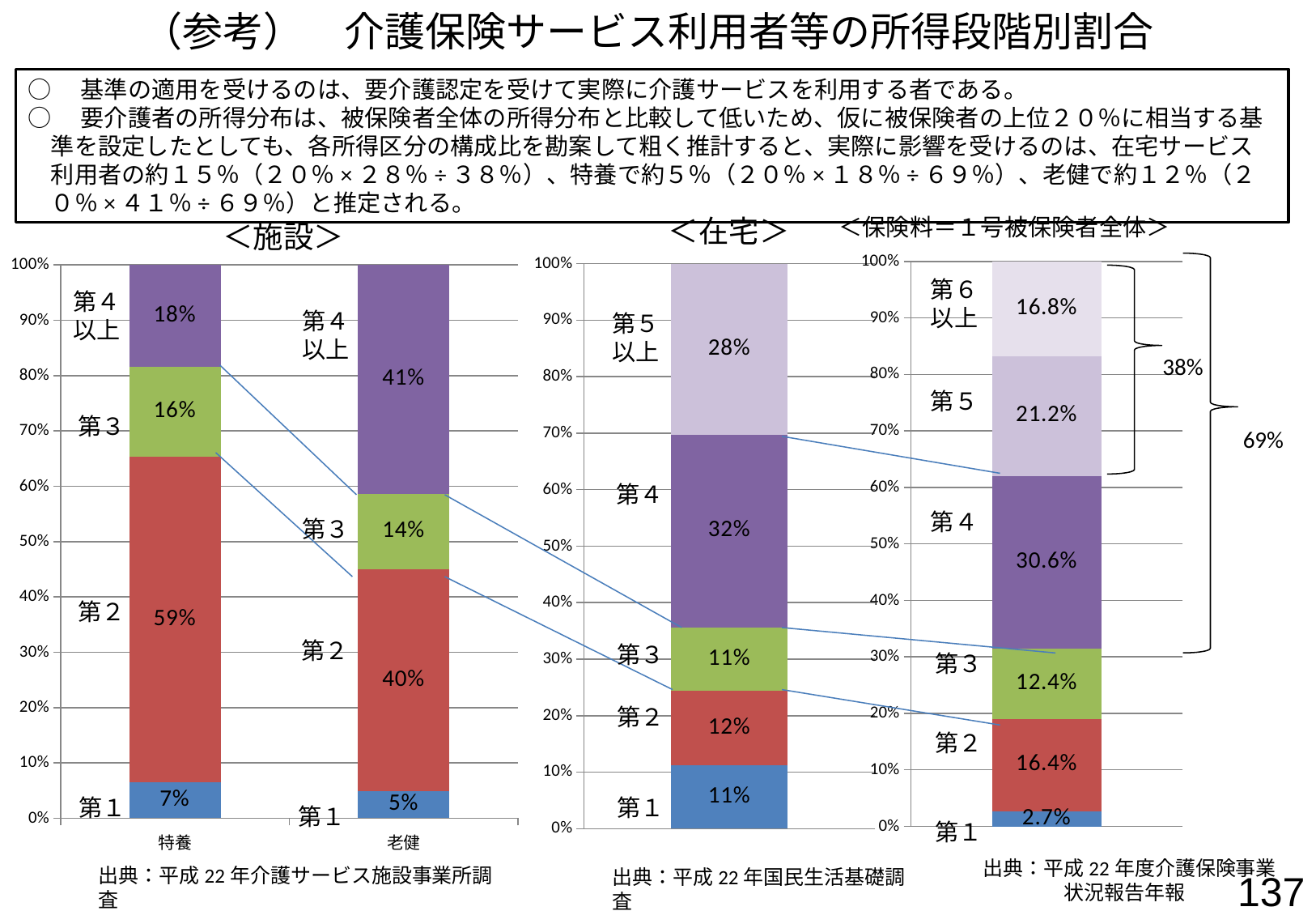
In the ＜施設＞ chart, what is the value of 第4以上 for 老健? 41% In the ＜施設＞ chart, what is the difference between the 第2 values for 特養 and 老健? 19% In the ＜在宅＞ chart, what is the value of 第4? 32% In the ＜施設＞ chart, what is the value of 第2 for 特養? 59% In the ＜施設＞ chart, which is larger: 第4以上 for 特養 or 第4以上 for 老健? 老健 What kind of chart is the ＜在宅＞ chart? Stacked bar chart How many bars are shown in the ＜施設＞ chart? 2 In the ＜保険料＝１号被保険者全体＞ chart, what is the value of 第1? 2.7% In the ＜施設＞ chart, what is the value of 第1 for 老健? 5% In the ＜施設＞ chart, which income segment has the largest share for 特養? 第2 In the ＜保険料＝１号被保険者全体＞ chart, what is the value of 第5? 21.2%